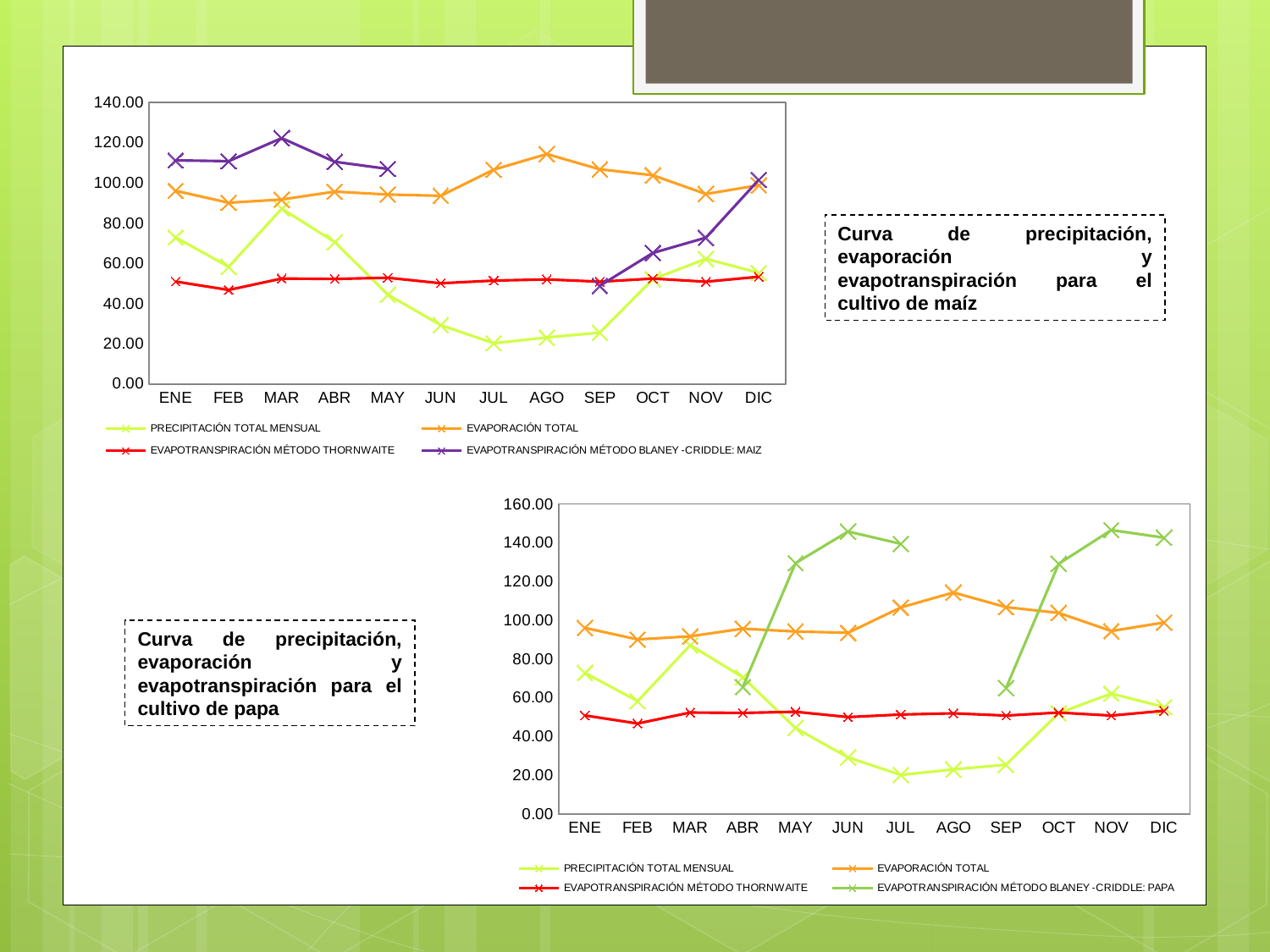
In the top chart (cultivo de maíz), in which month is PRECIPITACIÓN TOTAL MENSUAL highest? MAR In the top chart (cultivo de maíz), in which month is PRECIPITACIÓN TOTAL MENSUAL lowest? JUL In the bottom chart (cultivo de papa), in which month is EVAPORACIÓN TOTAL highest? AGO In the top chart (cultivo de maíz), which is larger in JUL: EVAPORACIÓN TOTAL or PRECIPITACIÓN TOTAL MENSUAL? EVAPORACIÓN TOTAL In the top chart (cultivo de maíz), is the value of PRECIPITACIÓN TOTAL MENSUAL in JUL greater or less than 40.00? less How many series does the legend of the top chart (cultivo de maíz) list? 4 What kind of chart is the top chart (cultivo de maíz)? line chart In the top chart (cultivo de maíz), is the value of EVAPOTRANSPIRACIÓN MÉTODO BLANEY-CRIDDLE: MAIZ in MAR greater or less than 100.00? greater In the bottom chart (cultivo de papa), is the value of EVAPOTRANSPIRACIÓN MÉTODO BLANEY-CRIDDLE: PAPA in JUN greater or less than 120.00? greater What is the highest value shown on the y axis of the bottom chart (cultivo de papa)? 160.00 In the top chart (cultivo de maíz), does PRECIPITACIÓN TOTAL MENSUAL rise or fall from MAR to JUL? fall How many months are shown on the x axis of the top chart (cultivo de maíz)? 12